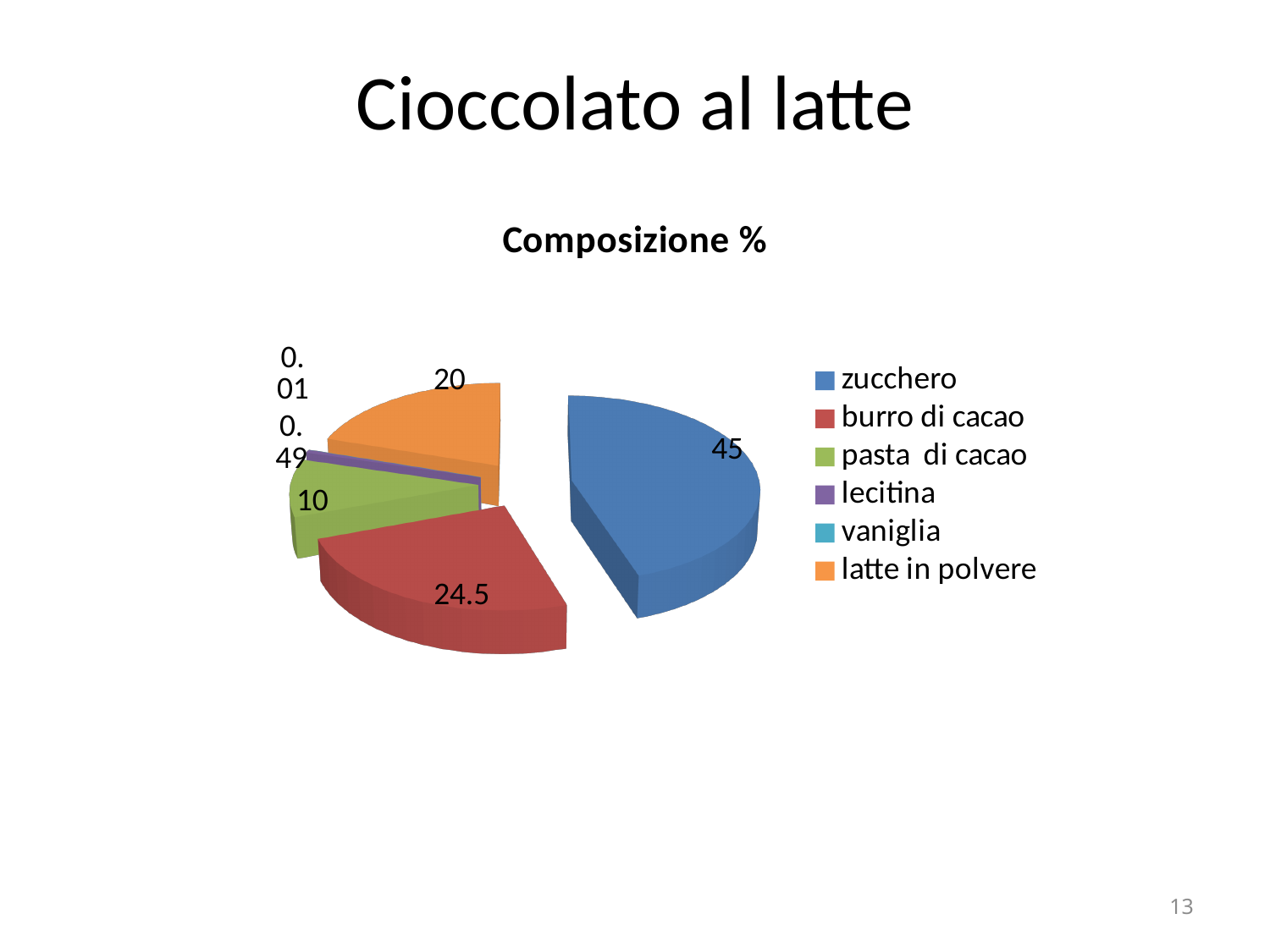
What is the value for latte in polvere? 20 What is the difference between the values for zucchero and burro di cacao? 20.5 Which is larger, burro di cacao or latte in polvere? burro di cacao What is the difference between the values for burro di cacao and pasta di cacao? 14.5 What kind of chart is shown on the slide? pie chart How many entries does the chart legend list? 6 What is the value for zucchero? 45 What is the title of the chart? Composizione % What is the value for pasta di cacao? 10 Which category has the largest slice of the pie? zucchero What is the value for burro di cacao? 24.5 Which colour represents latte in polvere in the chart? orange